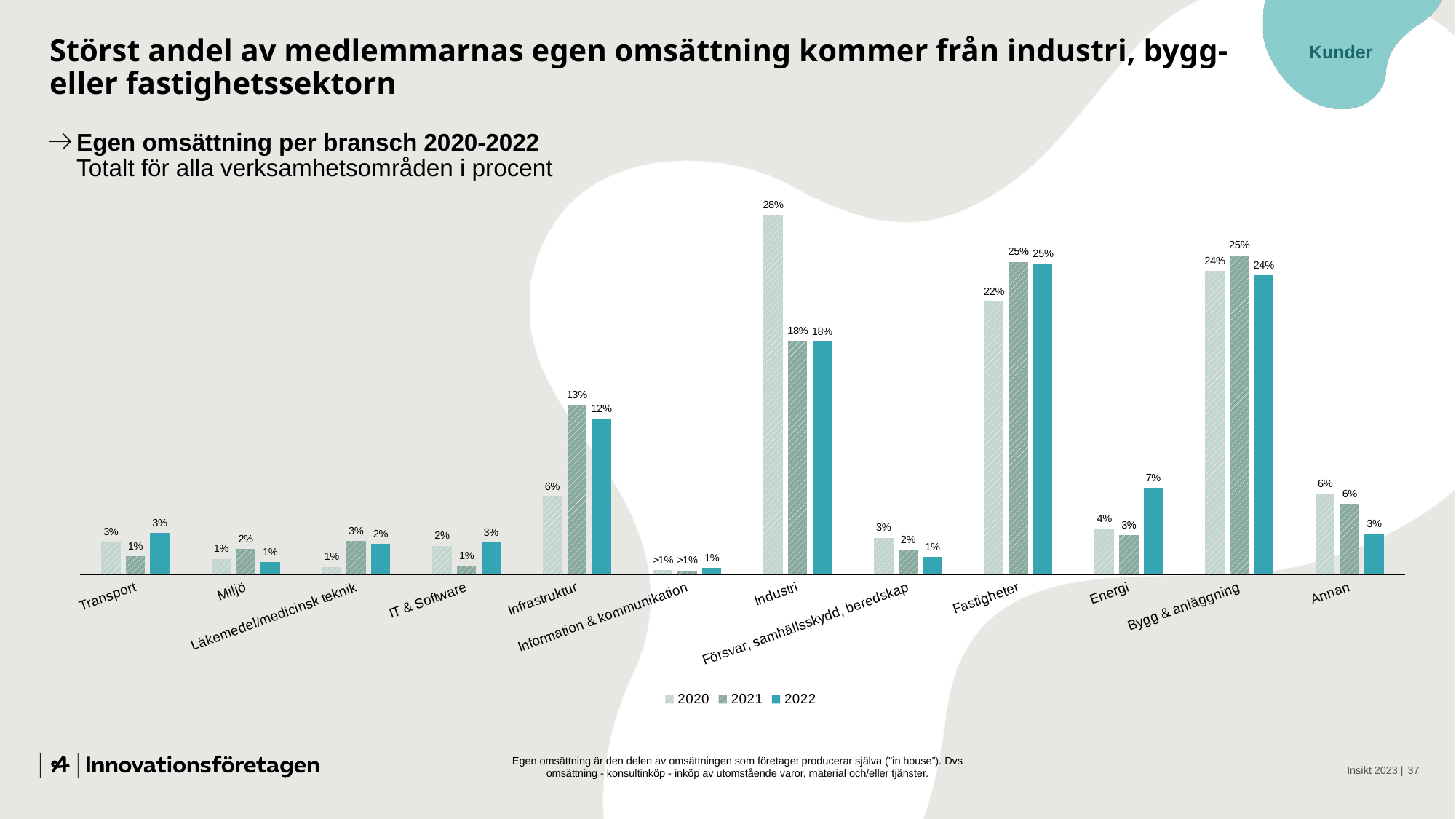
How many categories are shown on the x axis? 12 What is the value for Fastigheter in 2020? 22% What is the value for Energi in 2022? 7% Which category has the highest value for 2022? Fastigheter Do the values for Försvar, samhällsskydd, beredskap rise or fall from 2020 to 2022? Fall How many series does the legend list? 3 What is the value for Infrastruktur in 2021? 13% What is the value for Industri in 2020? 28% What is the difference between the 2020 and 2021 values for Industri? 10 percentage points For Infrastruktur, which year has the larger value, 2021 or 2022? 2021 Which category has the highest value for 2020? Industri What kind of chart is shown on the slide? Bar chart